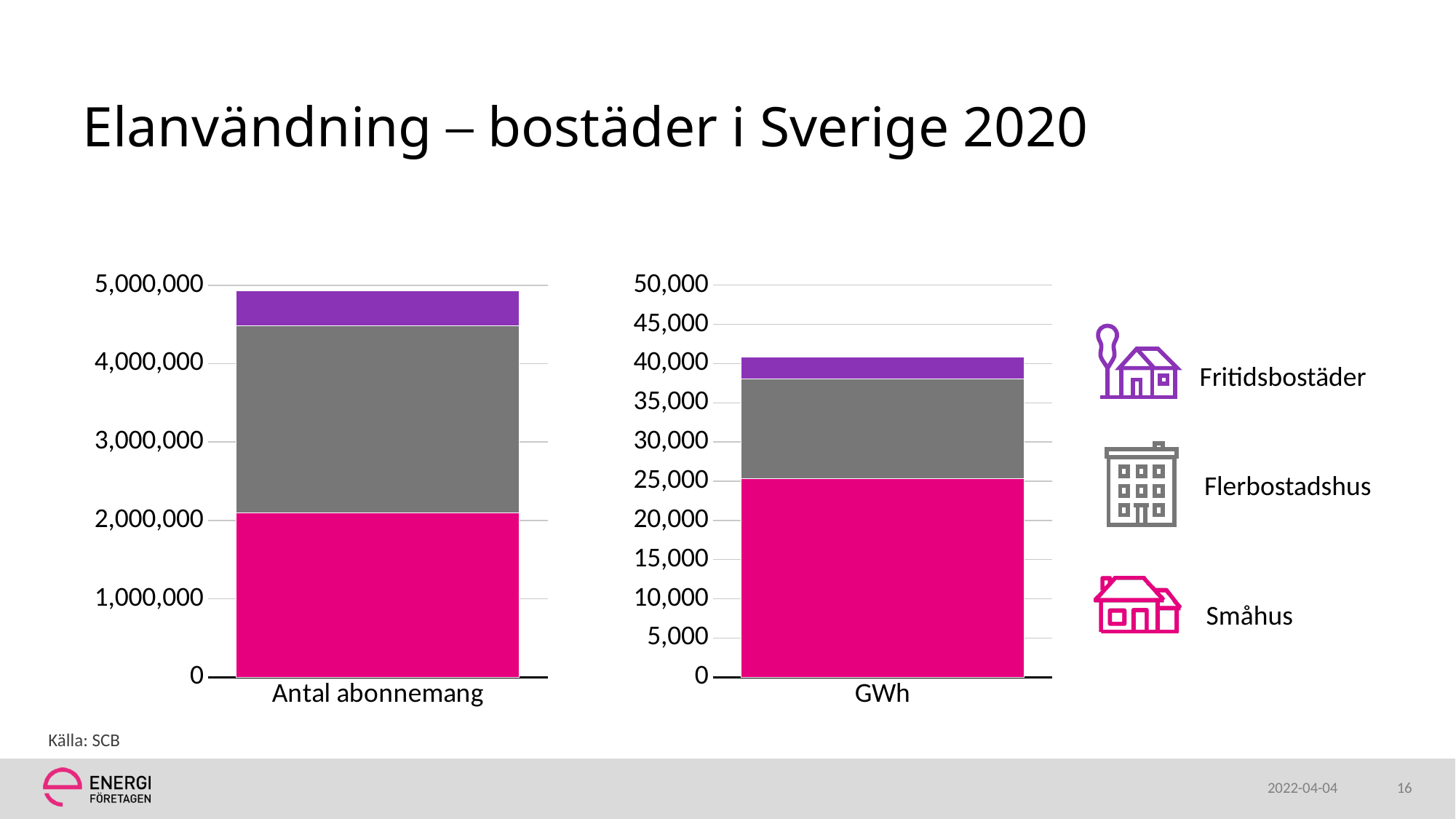
In the "Antal abonnemang" chart, is the total height of the stacked bar greater or less than 5,000,000? less In the "GWh" chart, which is larger, the Småhus segment or the Flerbostadshus segment? Småhus In the "Antal abonnemang" chart, is the value for Småhus greater or less than 2,000,000? greater Which series are listed in the legend? Fritidsbostäder, Flerbostadshus, Småhus In the "GWh" chart, which series has the largest segment? Småhus In the "Antal abonnemang" chart, which series has the smallest segment? Fritidsbostäder What kind of chart is used for the "Antal abonnemang" chart on the left? Stacked bar chart How many series does the legend list for the charts? 3 How many bars are plotted in the "Antal abonnemang" chart? 1 In the "GWh" chart, is the value for Småhus greater or less than 20,000? greater In the "GWh" chart, which colour represents Småhus? Pink